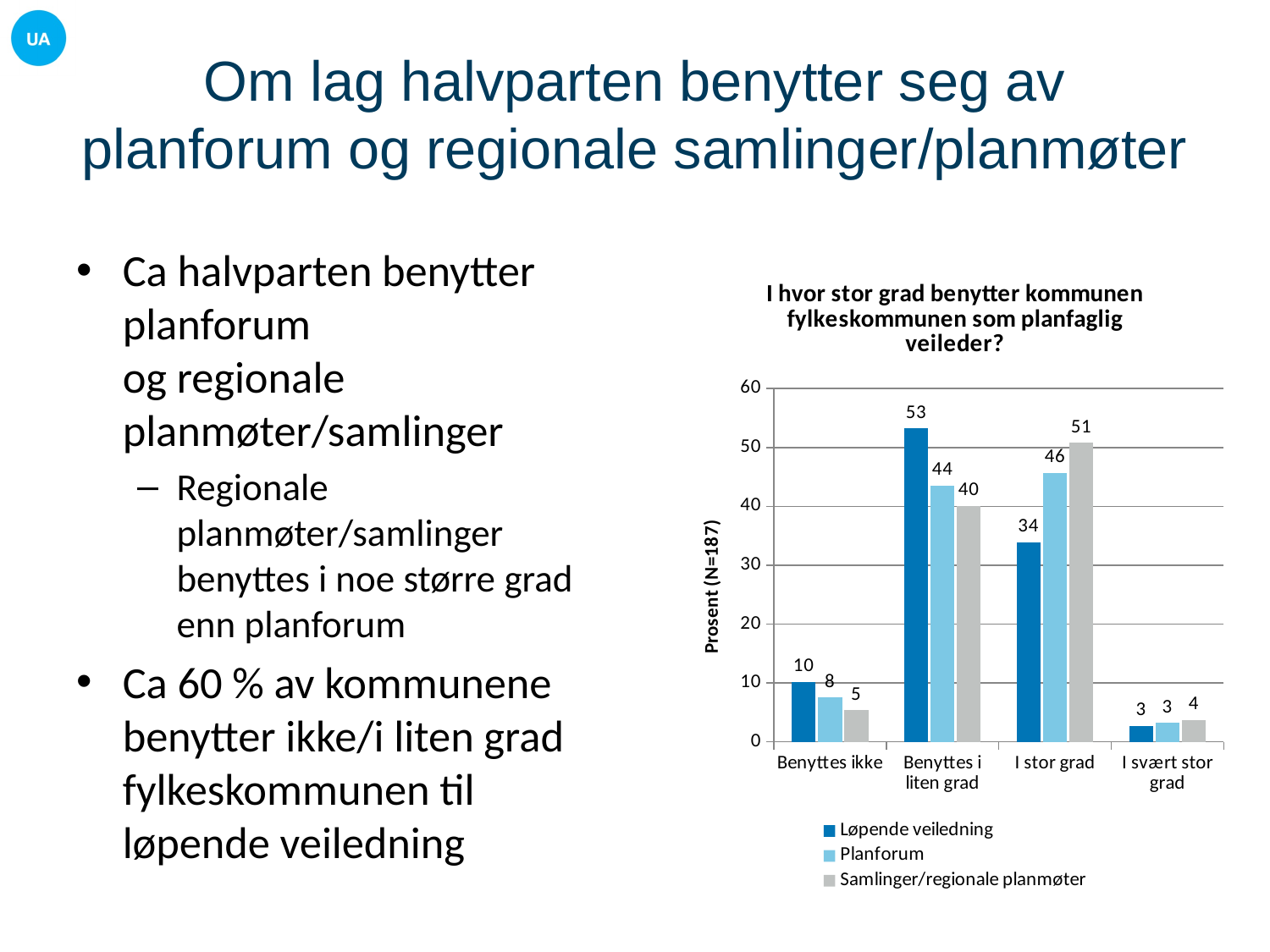
Which category has the highest value for Løpende veiledning? Benyttes i liten grad Is the value for Løpende veiledning in 'I stor grad' greater or less than 30? greater What is the difference between Løpende veiledning and Samlinger/regionale planmøter in the 'I stor grad' category? 17 How many series does the legend list? 3 How many categories are shown on the x axis? 4 What is the value for Planforum in the 'Benyttes ikke' category? 8 What is the value for Løpende veiledning in the 'Benyttes i liten grad' category? 53 What is the y-axis label of the chart? Prosent (N=187) In the 'Benyttes i liten grad' category, which is larger: Planforum or Samlinger/regionale planmøter? Planforum What kind of chart is shown on the slide? Bar chart Which category has the lowest value for Planforum? I svært stor grad What is the value for Samlinger/regionale planmøter in the 'I stor grad' category? 51